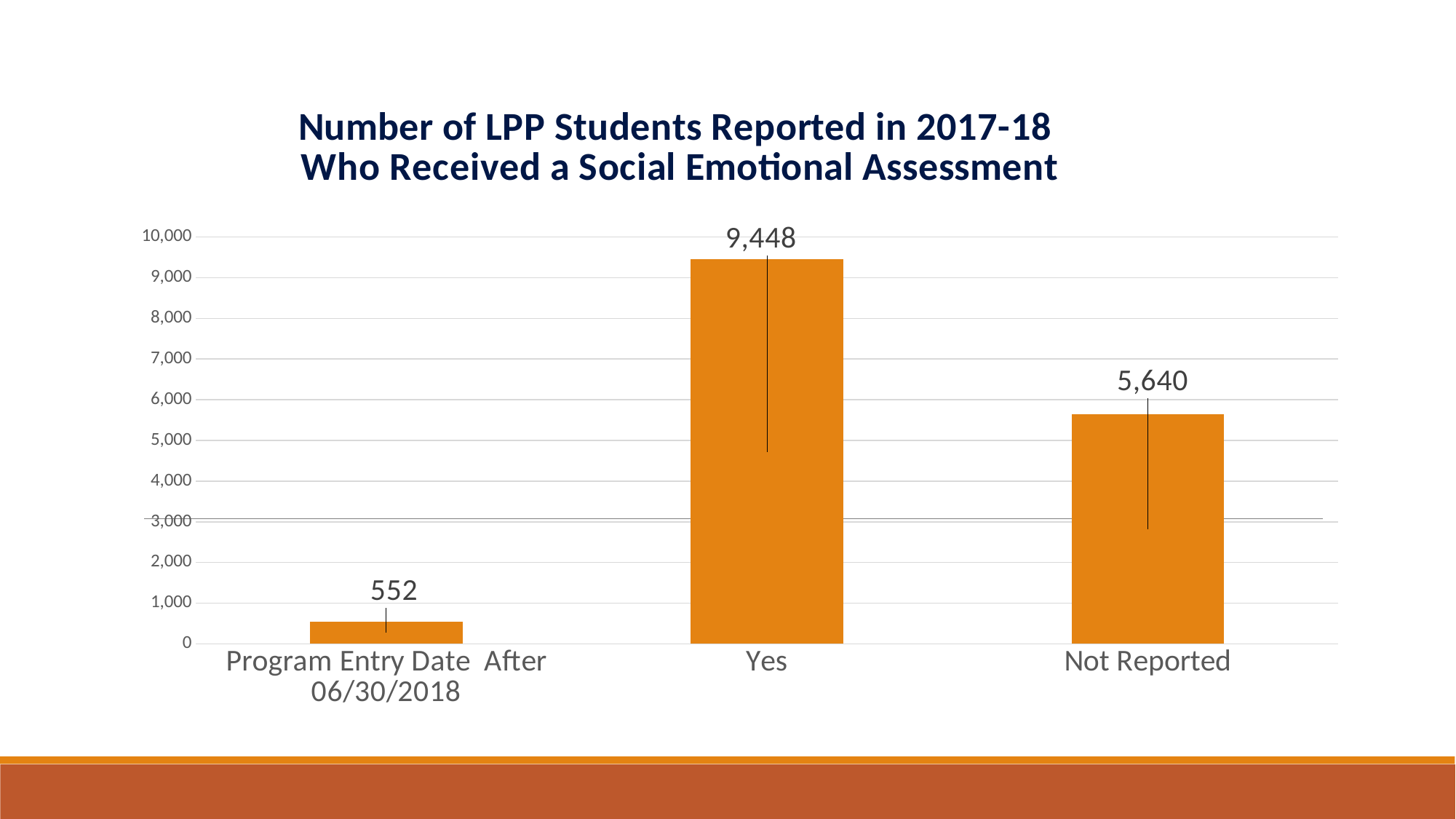
Is the value for "Not Reported" greater or less than 5,000? greater Which is larger, the value for "Not Reported" or the value for "Program Entry Date After 06/30/2018"? Not Reported What is the value for the "Program Entry Date After 06/30/2018" category? 552 Which category has the lowest value? Program Entry Date After 06/30/2018 Which category has the highest value? Yes What kind of chart is shown on the slide? Bar chart How many categories are shown on the chart? 3 What is the title of the chart? Number of LPP Students Reported in 2017-18 Who Received a Social Emotional Assessment What is the value for the "Not Reported" category? 5,640 What is the difference between the values for "Yes" and "Not Reported"? 3,808 What is the value for the "Yes" category? 9,448 What is the difference between the values for "Not Reported" and "Program Entry Date After 06/30/2018"? 5,088